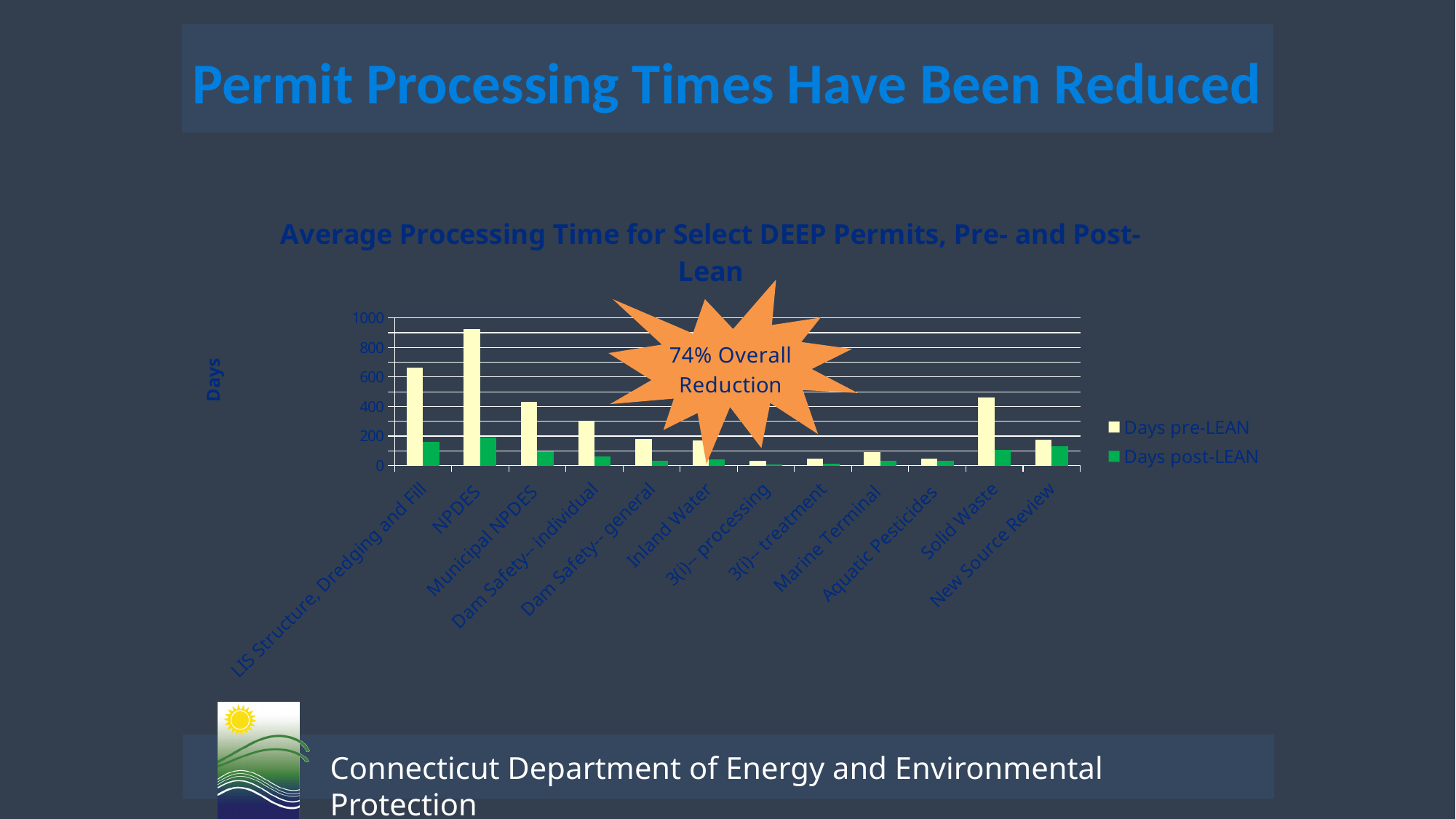
Is the Days pre-LEAN value for Solid Waste greater or less than 400? greater Which permit category has the lowest Days pre-LEAN value? 3(i)-- processing What kind of chart is shown on the slide? bar chart Is the Days pre-LEAN value for NPDES greater or less than 800? greater How many series does the chart legend list? 2 Which is larger for Municipal NPDES: Days pre-LEAN or Days post-LEAN? Days pre-LEAN What overall reduction is stated in the starburst callout on the chart? 74% Overall Reduction Which permit category has the highest Days pre-LEAN value? NPDES Is the Days post-LEAN value for Solid Waste greater or less than 200? less How many permit categories are shown on the x axis of the chart? 12 What is the title of the chart? Average Processing Time for Select DEEP Permits, Pre- and Post-Lean